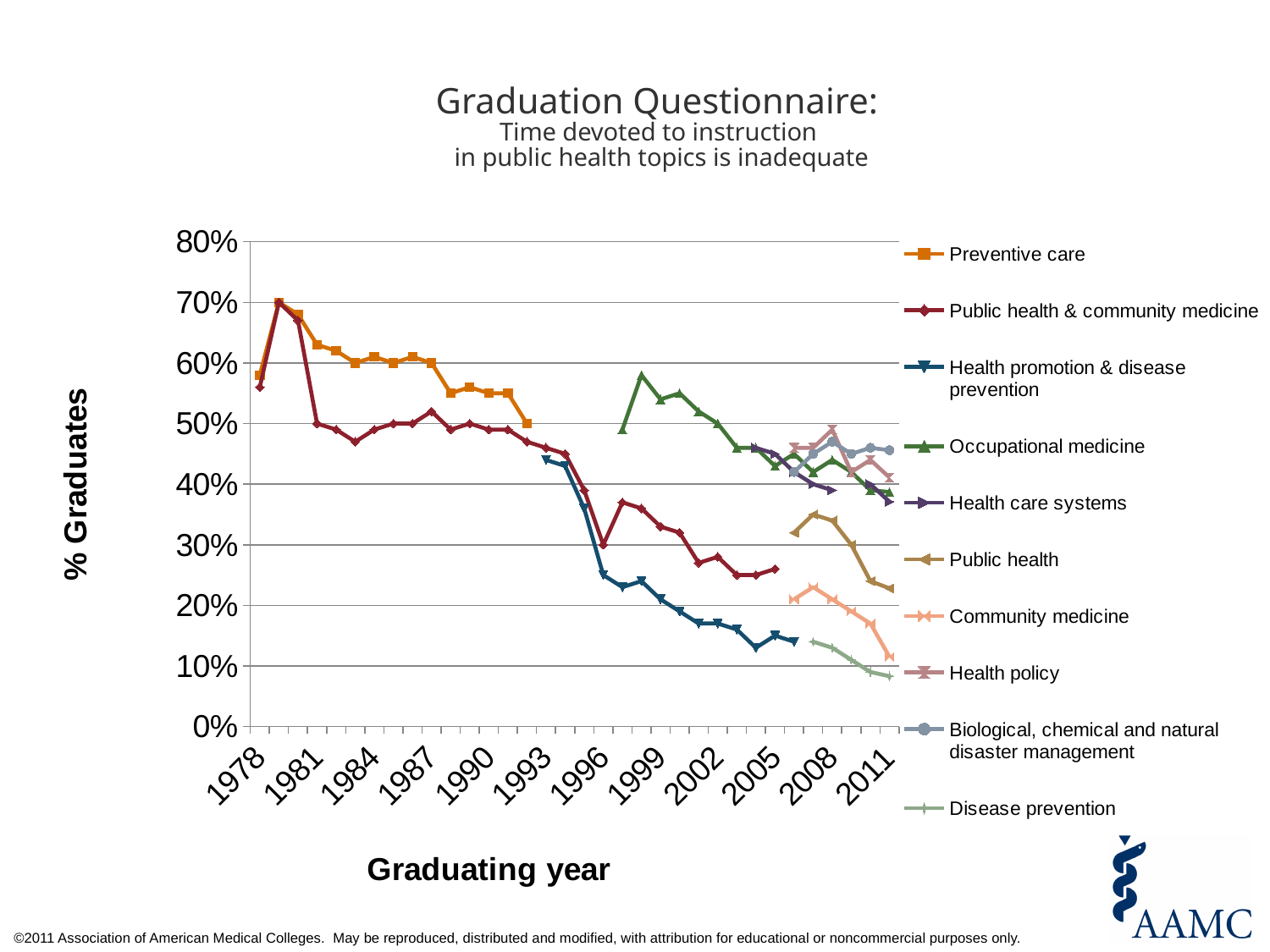
Is the value for Preventive care in 1978 greater or less than 50%? greater Is the value for Public health in 2011 greater or less than 30%? less In 1984, which is larger: Preventive care or Public health & community medicine? Preventive care Does the Health promotion & disease prevention line rise or fall from 1993 to 2005? fall Is the value for Health promotion & disease prevention in 2005 greater or less than 20%? less What is the title of the x axis? Graduating year How many series does the legend list? 10 What kind of chart is shown on the slide? line chart What is the title of the y axis? % Graduates How many year labels are shown along the x axis? 12